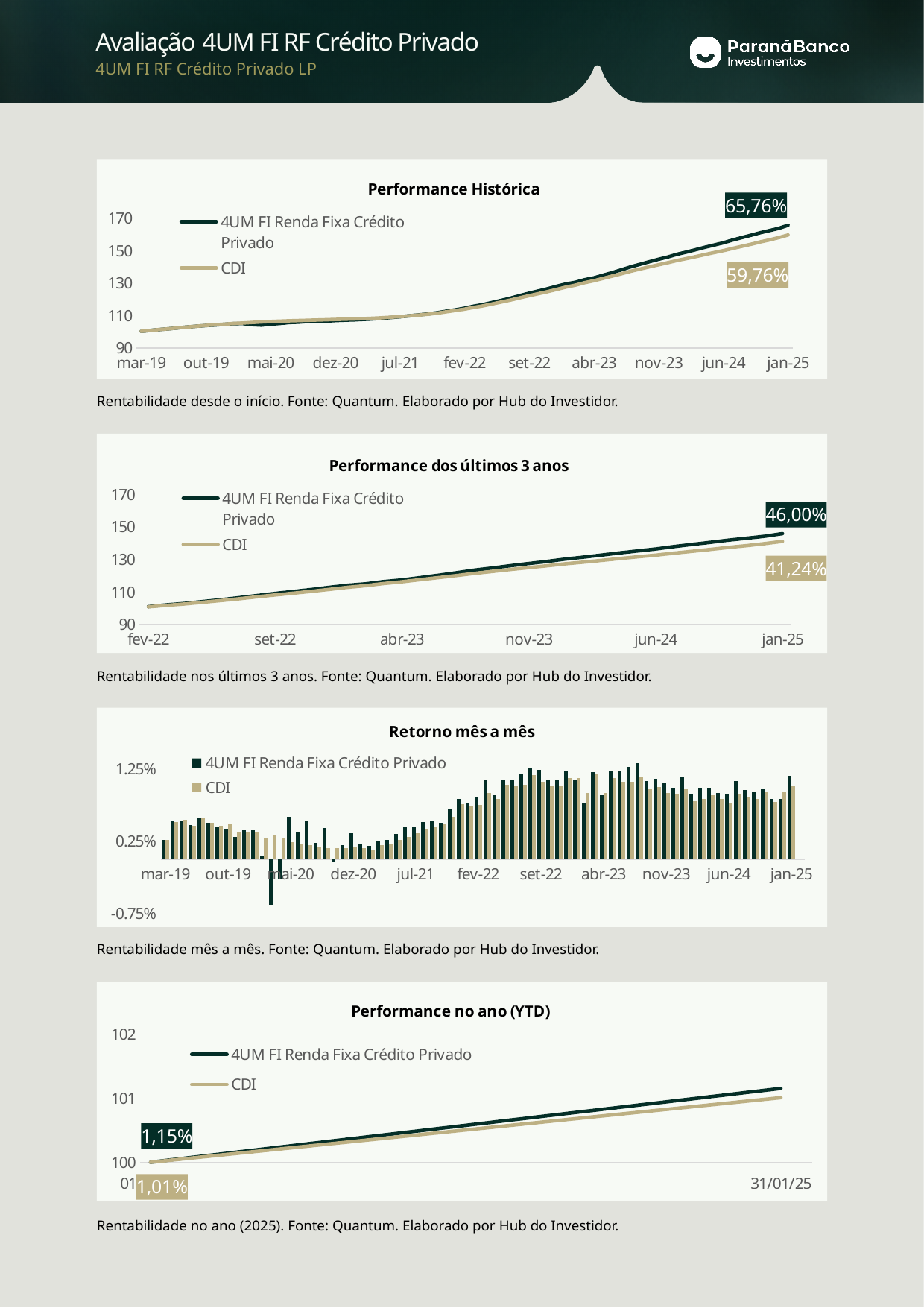
In the 'Performance Histórica' chart, what is the final value labelled for 4UM FI Renda Fixa Crédito Privado? 65,76% In the 'Performance dos últimos 3 anos' chart, do the lines rise or fall from fev-22 to jan-25? Rise What kind of chart is 'Retorno mês a mês'? Bar chart In the 'Performance dos últimos 3 anos' chart, what is the labelled value for CDI? 41,24% In the 'Performance no ano (YTD)' chart, what is the labelled value for CDI? 1,01% In the 'Performance dos últimos 3 anos' chart, what is the labelled value for 4UM FI Renda Fixa Crédito Privado? 46,00% What kind of chart is 'Performance Histórica'? Line chart How many series does the legend of the 'Performance Histórica' chart list? 2 In the 'Performance no ano (YTD)' chart, which series has the larger labelled value, 4UM FI Renda Fixa Crédito Privado or CDI? 4UM FI Renda Fixa Crédito Privado In the 'Performance Histórica' chart, what is the difference between the labelled values for 4UM FI Renda Fixa Crédito Privado and CDI? 6,00% In the 'Performance Histórica' chart, what is the final value labelled for CDI? 59,76% In the 'Performance dos últimos 3 anos' chart, what is the difference between the labelled values for 4UM FI Renda Fixa Crédito Privado and CDI? 4,76%